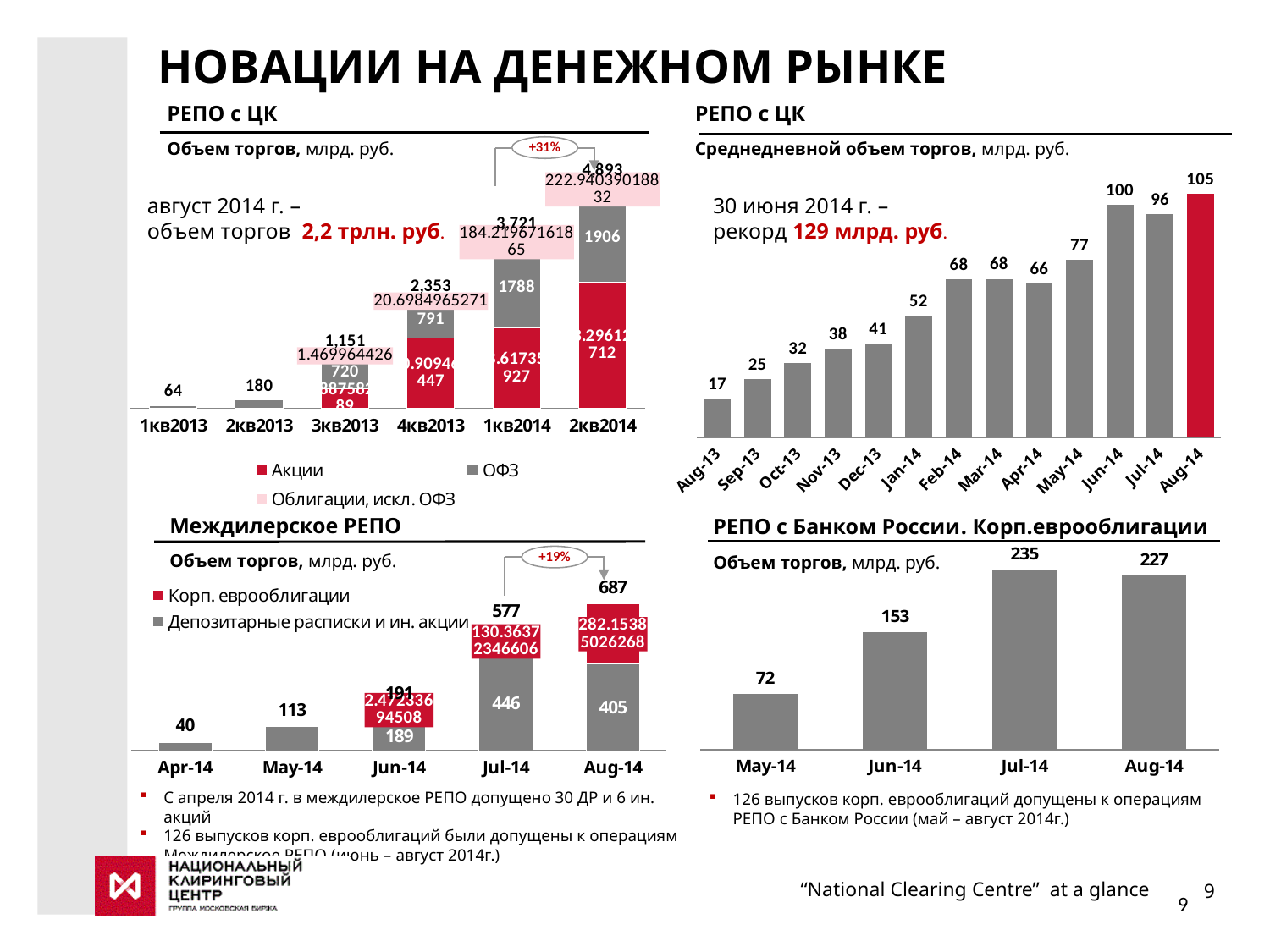
What type of chart is the bottom-right chart (РЕПО с Банком России. Корп.еврооблигации)? Bar chart In the top-right chart (РЕПО с ЦК, Среднедневной объем торгов), how many months are plotted? 13 In the top-left chart (РЕПО с ЦК, Объем торгов), what is the total for 2кв2014? 4,893 In the top-left chart (РЕПО с ЦК, Объем торгов), how many series does the legend list? 3 In the bottom-right chart (РЕПО с Банком России. Корп.еврооблигации), which month has the highest value? Jul-14 In the bottom-left chart (Междилерское РЕПО), what is the total for Aug-14? 687 In the top-right chart (РЕПО с ЦК, Среднедневной объем торгов), what is the value for Aug-14? 105 In the top-left chart (РЕПО с ЦК, Объем торгов), what is the total for 1кв2013? 64 In the bottom-right chart (РЕПО с Банком России. Корп.еврооблигации), what is the value for Jun-14? 153 In the top-right chart (РЕПО с ЦК, Среднедневной объем торгов), which month has the lowest value? Aug-13 In the top-right chart (РЕПО с ЦК, Среднедневной объем торгов), what is the difference between Jun-14 and Jul-14? 4 In the bottom-left chart (Междилерское РЕПО), which is larger: the total for May-14 or the total for Jun-14? Jun-14